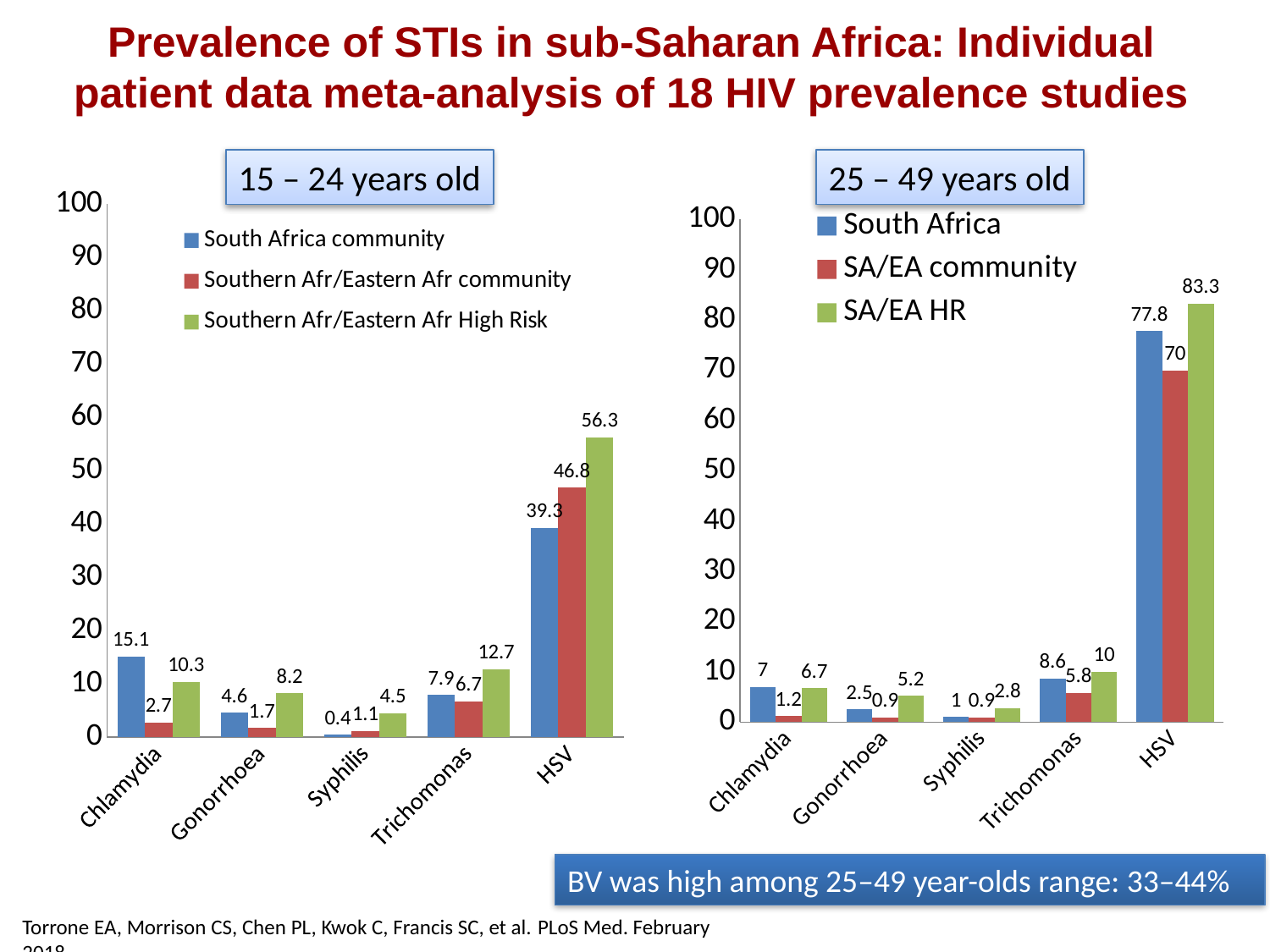
What type of chart is the 25 – 49 years old chart? Bar chart In the 25 – 49 years old chart, what is the difference between the SA/EA HR and South Africa values for HSV? 5.5 In the 25 – 49 years old chart, which category has the lowest value for SA/EA HR? Syphilis In the 25 – 49 years old chart, what is the value for South Africa for Trichomonas? 8.6 In the 15 – 24 years old chart, which is larger for Trichomonas: South Africa community or Southern Afr/Eastern Afr High Risk? Southern Afr/Eastern Afr High Risk In the 15 – 24 years old chart, what colour represents Southern Afr/Eastern Afr High Risk? Green In the 15 – 24 years old chart, what is the value for Southern Afr/Eastern Afr High Risk for HSV? 56.3 In the 15 – 24 years old chart, what is the value for South Africa community for Chlamydia? 15.1 In the 25 – 49 years old chart, what is the value for SA/EA community for HSV? 70 In the 15 – 24 years old chart, which category has the highest value for Southern Afr/Eastern Afr community? HSV How many categories are shown on the x axis of the 25 – 49 years old chart? 5 How many series does the legend of the 15 – 24 years old chart list? 3